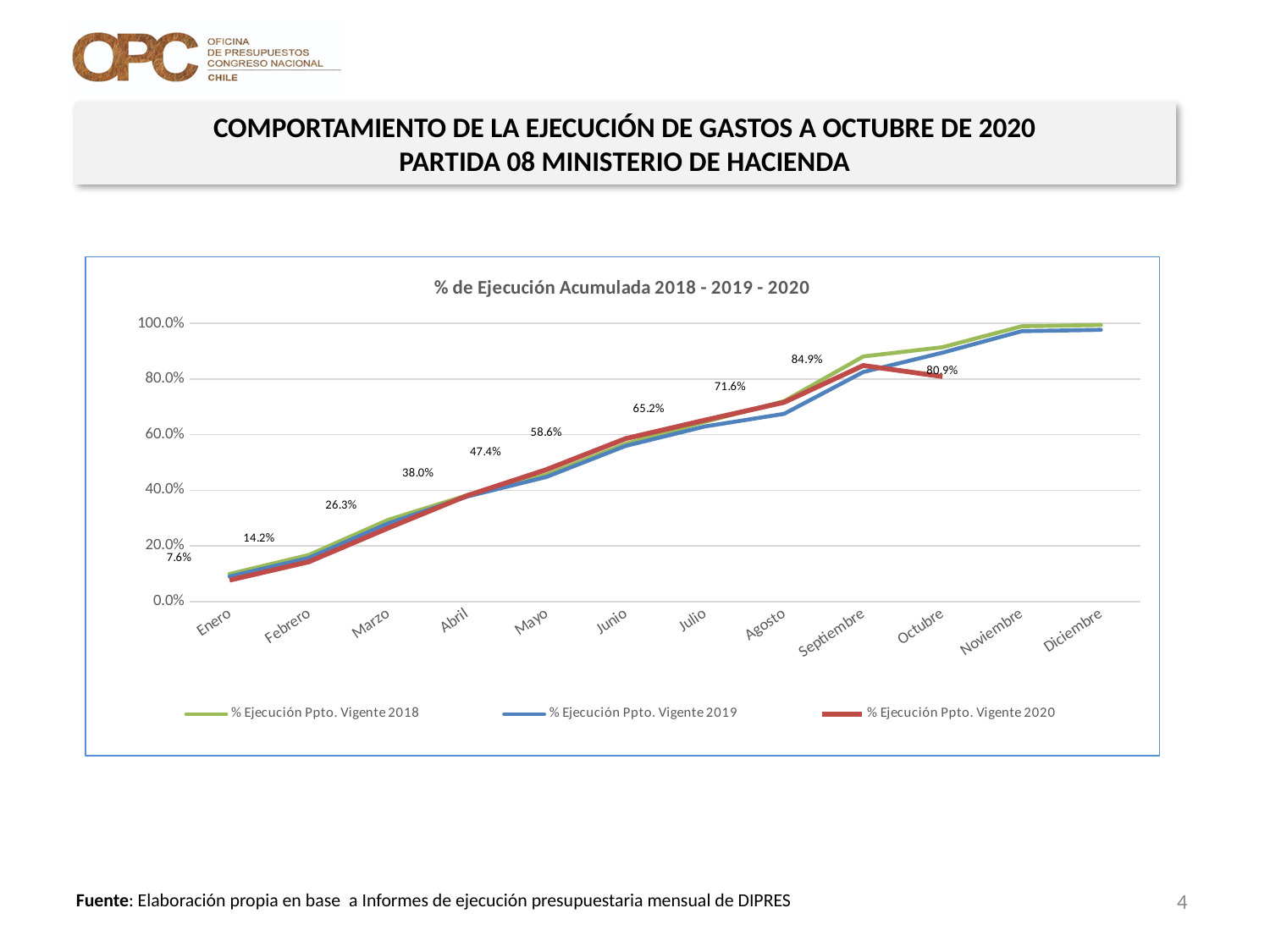
What kind of chart is shown on the slide? Line chart What is the value for % Ejecución Ppto. Vigente 2020 in Abril? 38.0% For the 2020 series, which is larger: the value for Septiembre or the value for Octubre? Septiembre Is the value for % Ejecución Ppto. Vigente 2019 in Agosto greater or less than 80.0%? less What is the difference between the 2020 values for Septiembre and Octubre? 4.0 percentage points What is the title of the chart? % de Ejecución Acumulada 2018 - 2019 - 2020 How many series does the legend list? 3 Does the 2020 series rise or fall from Enero to Septiembre? Rise What is the value for % Ejecución Ppto. Vigente 2020 in Octubre? 80.9% What is the value for % Ejecución Ppto. Vigente 2020 in Enero? 7.6% How many months are shown on the x axis? 12 What is the value for % Ejecución Ppto. Vigente 2020 in Septiembre? 84.9%